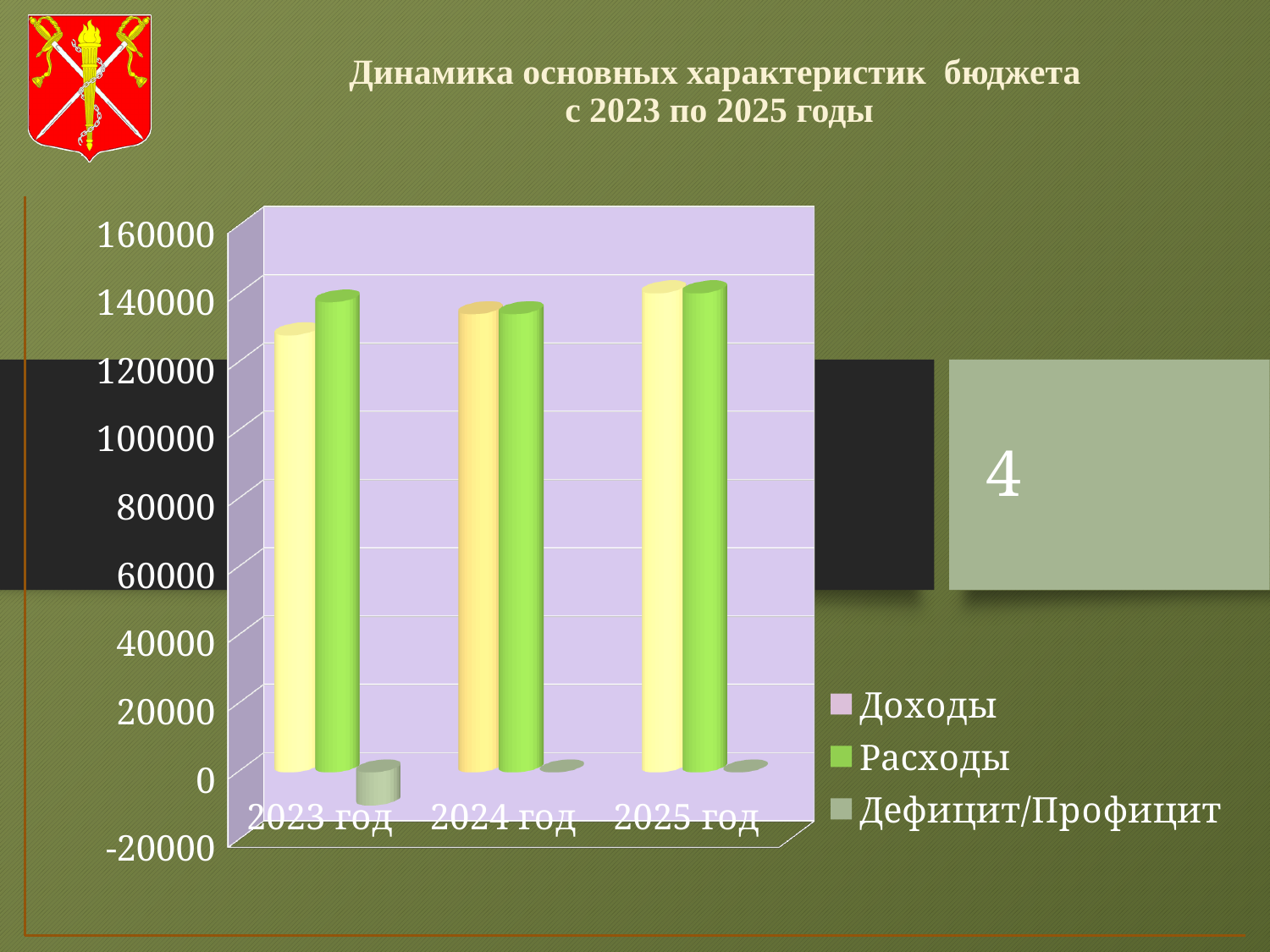
Do the Доходы values rise or fall from 2023 год to 2025 год? rise What is the title of the chart? Динамика основных характеристик бюджета с 2023 по 2025 годы Is the value of Дефицит/Профицит for 2023 год greater or less than 0? less How many categories (years) are shown on the x axis? 3 What kind of chart is shown on the slide? bar chart In which year is Доходы the highest? 2025 год Is the value of Доходы for 2023 год greater or less than 140000? less Is the value of Расходы for 2023 год greater or less than 120000? greater How many series does the legend list? 3 Which series is shown in green in the legend? Расходы For 2023 год, which is larger: Доходы or Расходы? Расходы In which year is Доходы the lowest? 2023 год